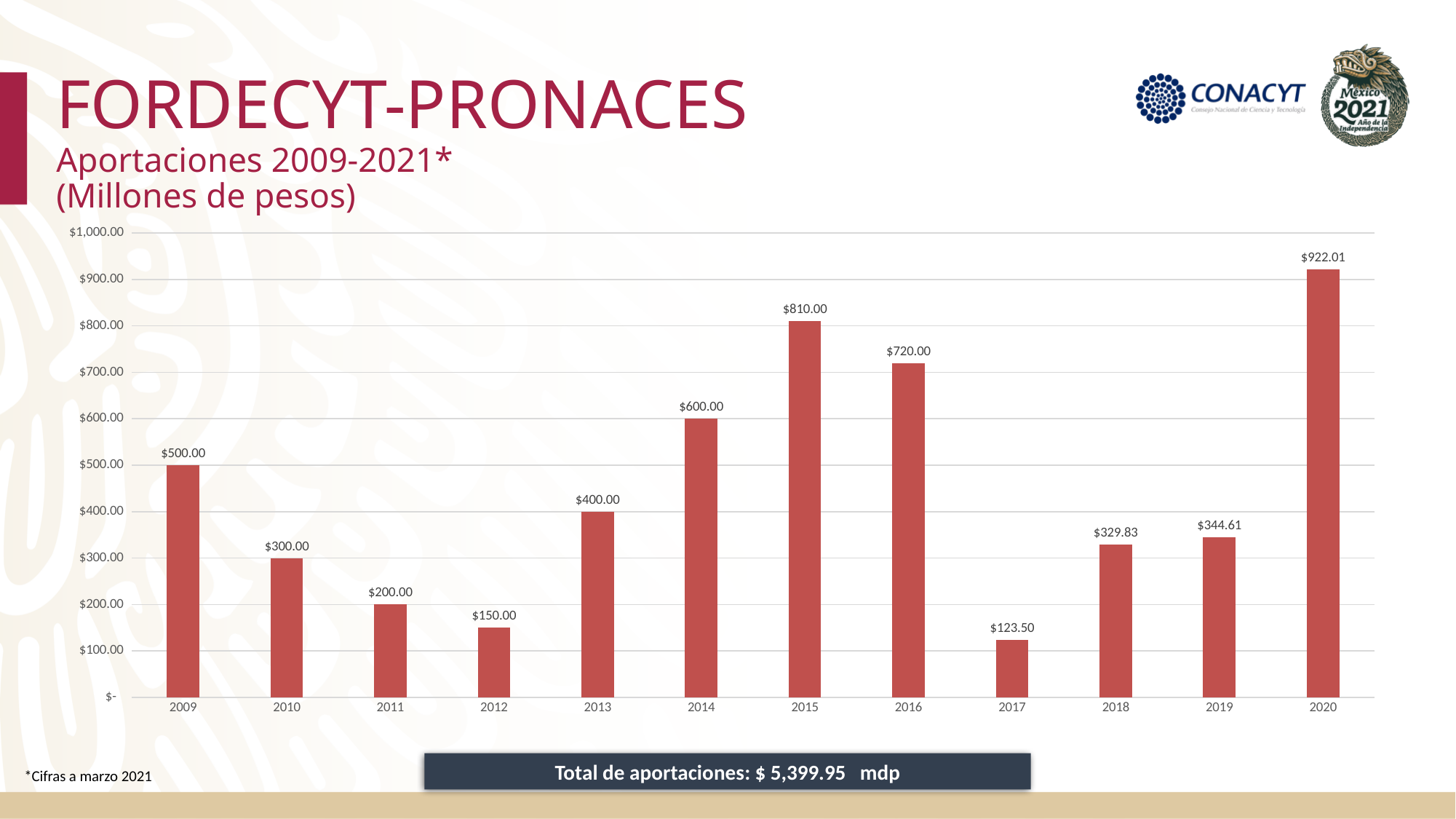
What is the subtitle of the chart below the title FORDECYT-PRONACES? Aportaciones 2009-2021* (Millones de pesos) What is the value for 2017? $123.50 Which year has the lowest value? 2017 What is the difference between the values for 2016 and 2014? $120.00 How many years are shown on the x axis? 12 Which year has the highest value? 2020 What kind of chart is shown on the slide? bar chart What is the value for 2015? $810.00 What is the value for 2019? $344.61 Is the value for 2020 greater or less than $900.00? greater Do the values rise or fall from 2009 to 2012? fall Which is larger, the value for 2018 or the value for 2019? 2019